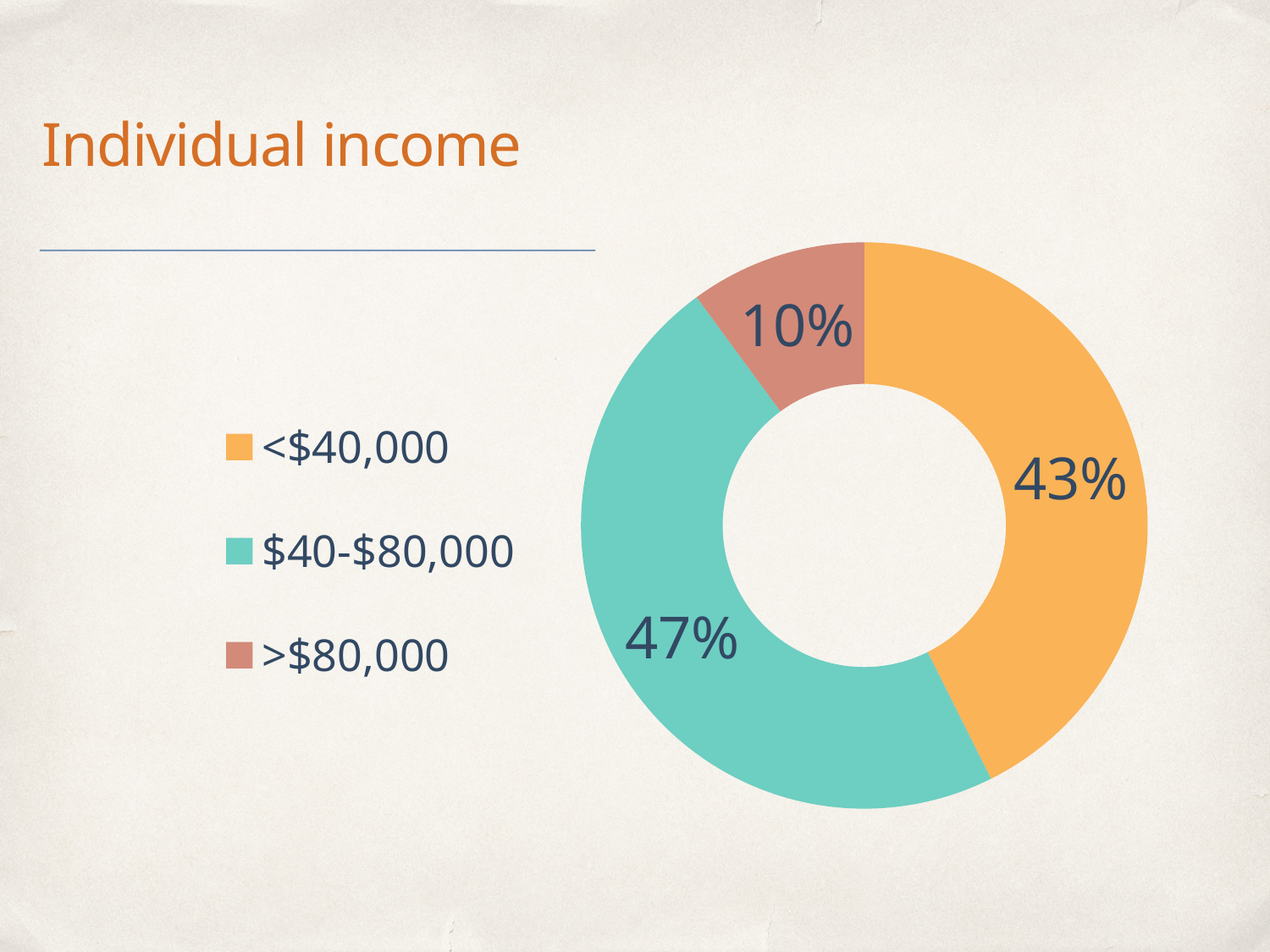
How many income categories are shown in the chart? 3 What percentage of individuals have an income of $40-$80,000? 47% What kind of chart is shown on the slide? Pie chart (doughnut) Which income category has the smallest share? >$80,000 What percentage of individuals have an income of >$80,000? 10% What is the difference in percentage points between the <$40,000 and >$80,000 categories? 33 What percentage of individuals have an income of <$40,000? 43% Which is larger: the share for <$40,000 or the share for >$80,000? <$40,000 What is the difference in percentage points between the $40-$80,000 and <$40,000 categories? 4 Which income category has the largest share? $40-$80,000 What colour represents the $40-$80,000 category? Teal What is the title of the slide? Individual income